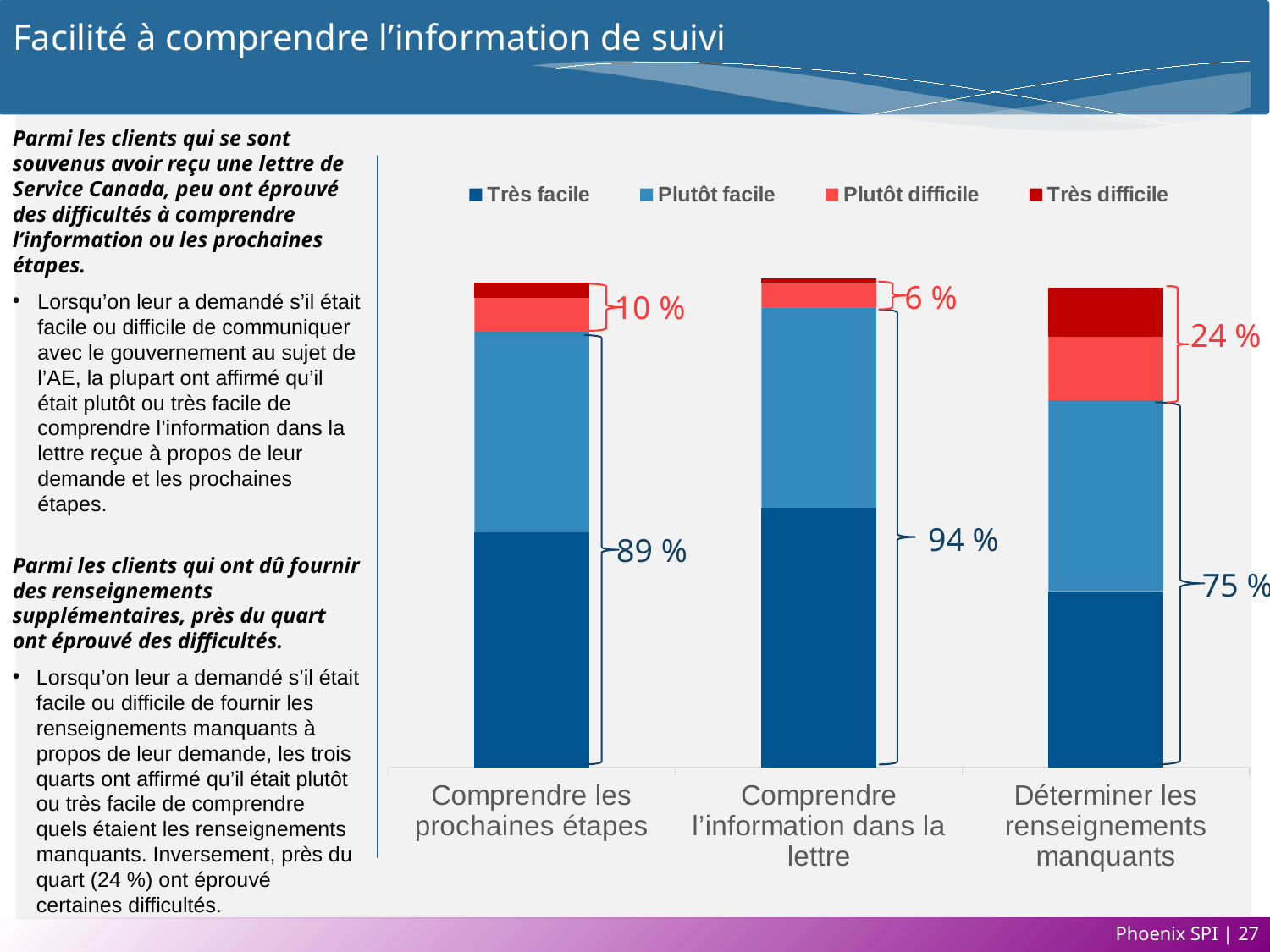
How many categories are shown along the x axis of the chart? 3 Which category has the highest combined 'facile' share? Comprendre l'information dans la lettre Which category has the lowest combined 'facile' share? Déterminer les renseignements manquants What combined share of respondents found it 'Plutôt difficile' or 'Très difficile' for 'Déterminer les renseignements manquants'? 24 % What combined share of respondents found it easy ('Très facile' or 'Plutôt facile') for 'Comprendre l'information dans la lettre'? 94 % What combined share of respondents found it difficult for 'Comprendre l'information dans la lettre'? 6 % Which legend entry is shown in the darkest red colour? Très difficile What kind of chart is shown on the slide? Stacked bar chart What is the difference between the combined 'facile' share for 'Comprendre l'information dans la lettre' and for 'Déterminer les renseignements manquants'? 19 % What combined share of respondents found it 'Très facile' or 'Plutôt facile' for 'Comprendre les prochaines étapes'? 89 % How many series does the chart legend list? 4 Which category has the larger combined 'difficile' share: 'Comprendre les prochaines étapes' or 'Déterminer les renseignements manquants'? Déterminer les renseignements manquants